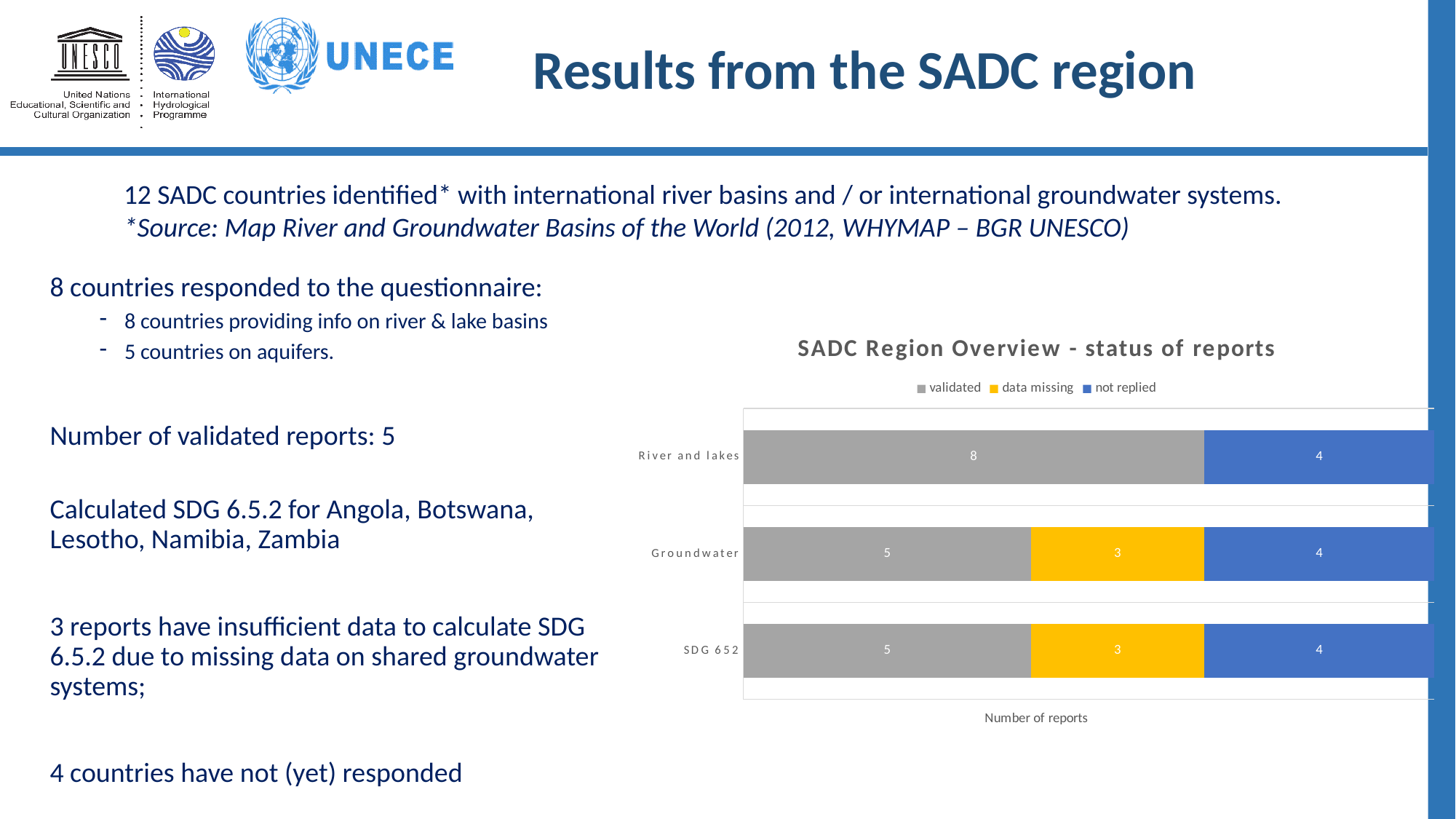
What is the title of the chart? SADC Region Overview - status of reports How many series does the chart legend list? 3 What kind of chart is shown on the slide? stacked bar chart What is the label of the horizontal axis? Number of reports What is the not replied value for SDG 652? 4 What is the total number of reports for the Groundwater bar? 12 How many categories are shown on the chart? 3 What is the difference between the validated values for River and lakes and Groundwater? 3 Which is larger for SDG 652: the validated value or the not replied value? validated Which category has the highest validated value? River and lakes What is the validated value for River and lakes? 8 What is the data missing value for Groundwater? 3